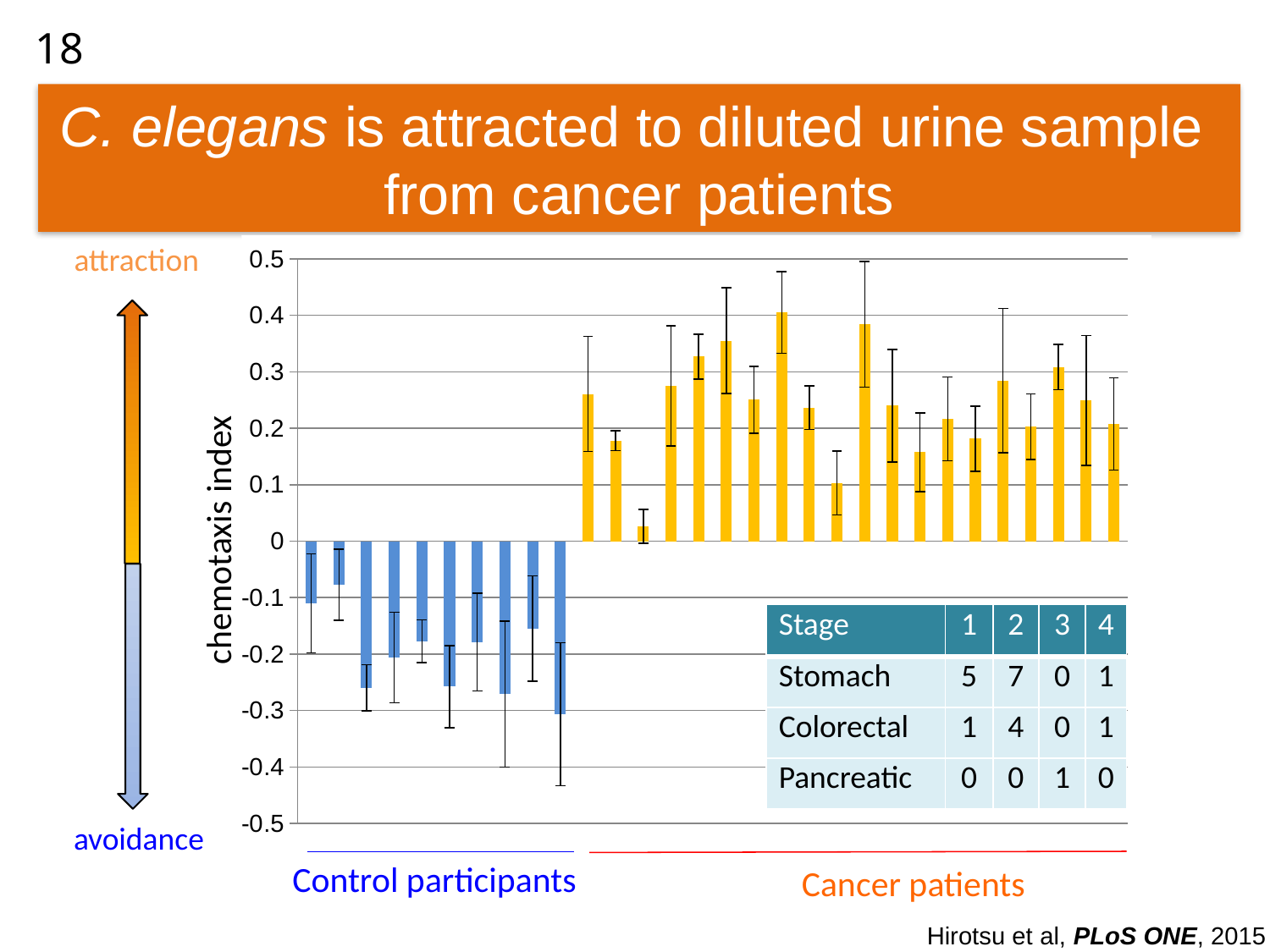
Is the value of the first (leftmost) control participant bar greater or less than -0.2? greater Is the value of the third cancer patient bar (the shortest orange bar) greater or less than 0.1? less Are the chemotaxis index values for the control participants positive or negative? negative Is the tallest cancer patient bar greater or less than 0.3? greater How many control participant bars are plotted in the chart? 10 What is the label of the y axis of the chart? chemotaxis index Which group has the higher chemotaxis index values, control participants or cancer patients? Cancer patients Which group of bars corresponds to attraction, according to the arrow on the left of the chart? Cancer patients What is the highest value shown on the y axis of the chart? 0.5 What kind of chart is shown on the slide? bar chart